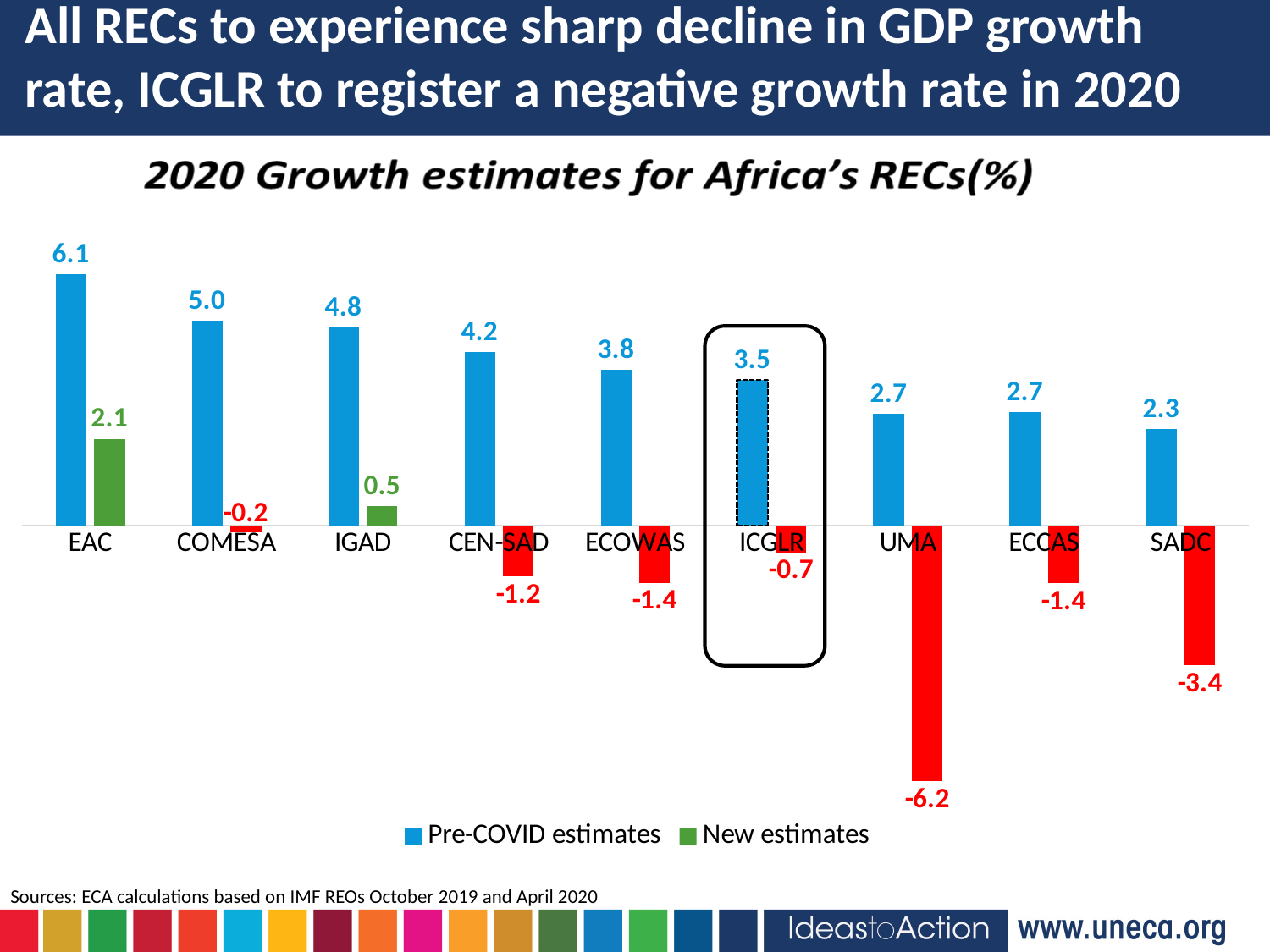
Which REC has the lowest New estimate? UMA Which is larger, the Pre-COVID estimate for COMESA or the Pre-COVID estimate for IGAD? COMESA What is the Pre-COVID estimate for EAC? 6.1 How many series does the legend list? 2 What is the New estimate for ICGLR? -0.7 What is the New estimate for UMA? -6.2 Do the Pre-COVID estimates rise or fall from EAC to SADC along the x axis? Fall How many RECs are shown on the x axis? 9 What is the difference between the Pre-COVID estimate and the New estimate for SADC? 5.7 What is the title of the chart? 2020 Growth estimates for Africa's RECs(%) What kind of chart is shown on the slide? Bar chart Which REC has the highest Pre-COVID estimate? EAC